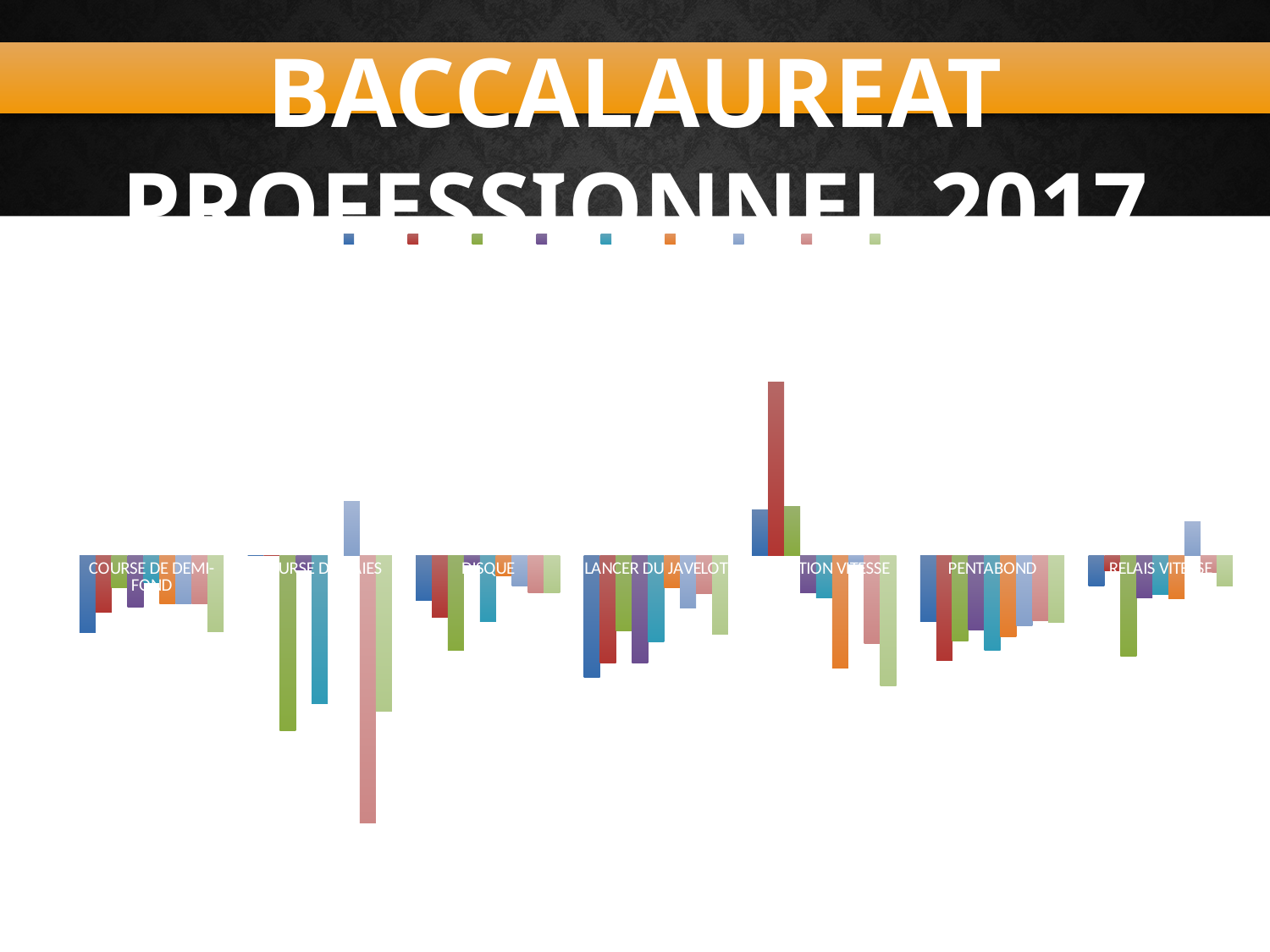
Which is the last category on the x axis? RELAIS VITESSE What is the title shown above the chart? BACCALAUREAT PROFESSIONNEL 2017 Which is the first category on the x axis? COURSE DE DEMI-FOND Which category contains the tallest bar above the baseline? NATATION VITESSE How many series does the legend list? 9 Which category comes immediately after DISQUE on the x axis? LANCER DU JAVELOT In the PENTABOND category, are the bars above or below the baseline? below How many categories are shown along the x axis of the chart? 7 What kind of chart is shown on the slide? bar chart